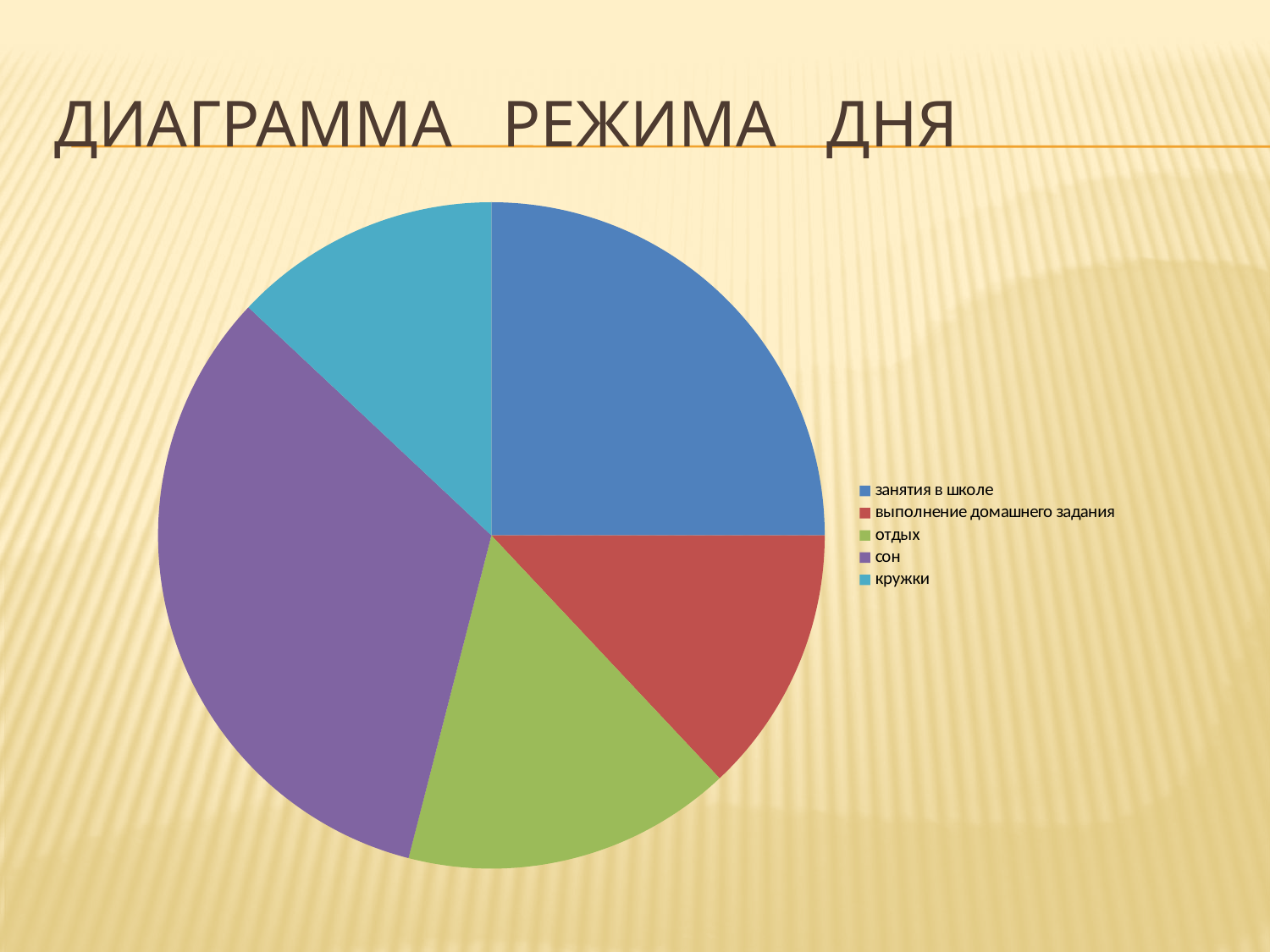
Which slice is larger: сон or кружки? сон Which slice is larger: занятия в школе or отдых? занятия в школе How many categories does the pie chart show? 5 What kind of chart is shown on the slide? pie chart Which slice is larger: занятия в школе or выполнение домашнего задания? занятия в школе Which category has the largest slice of the pie? сон What is the title of the slide? ДИАГРАММА РЕЖИМА ДНЯ Which colour represents кружки in the legend? light blue